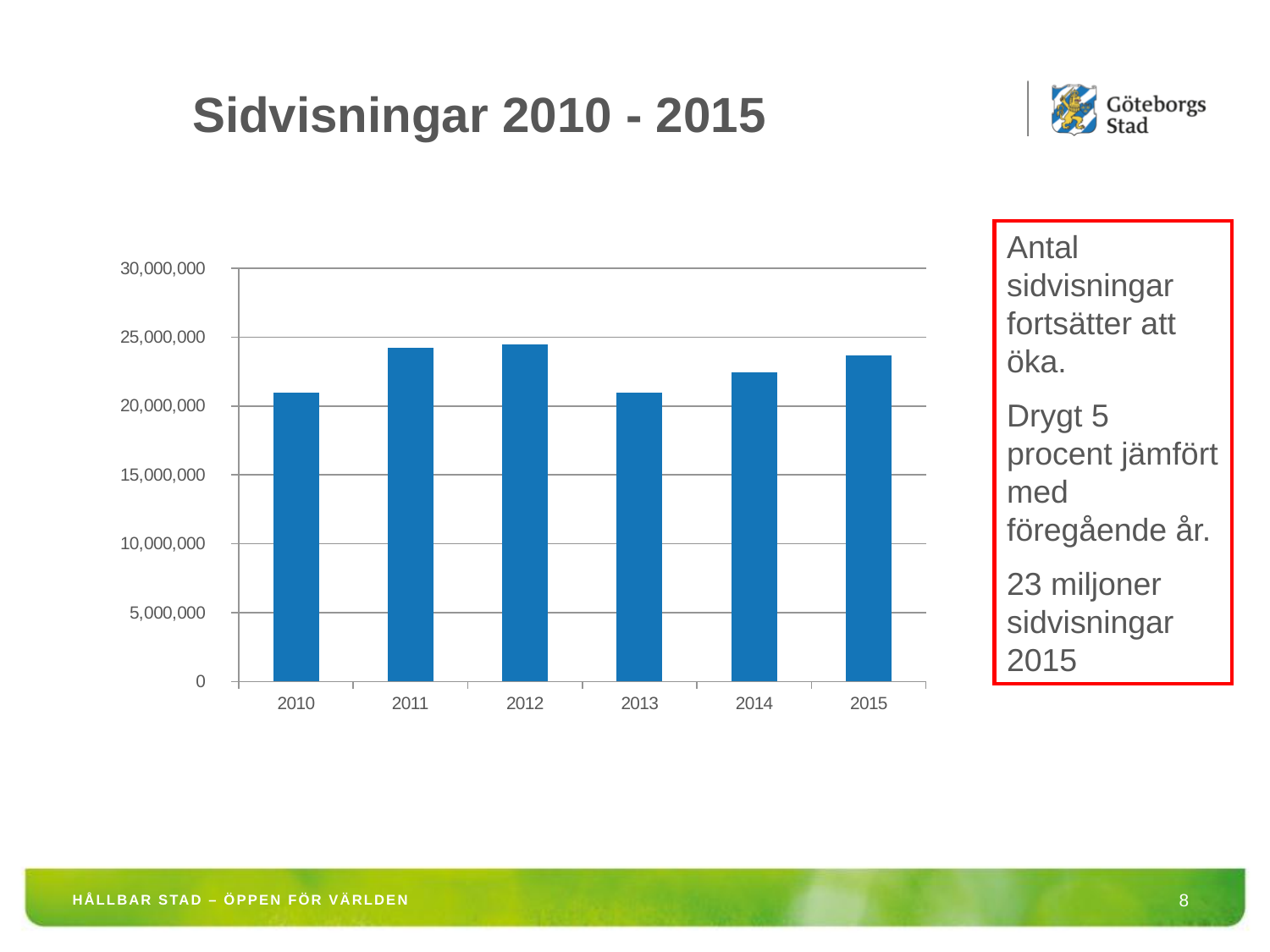
Is the value for 2014 greater or less than 20,000,000? greater How many years (bars) are plotted in the chart? 6 Which year has the larger value, 2014 or 2015? 2015 Is the value for 2013 greater or less than 25,000,000? less Which year has the larger value, 2012 or 2013? 2012 What is the title of the slide's chart? Sidvisningar 2010 - 2015 Which year has the larger value, 2010 or 2011? 2011 What kind of chart is shown on the slide? bar chart Is the value for 2011 greater or less than 25,000,000? less From 2013 to 2015, do the values rise or fall? rise